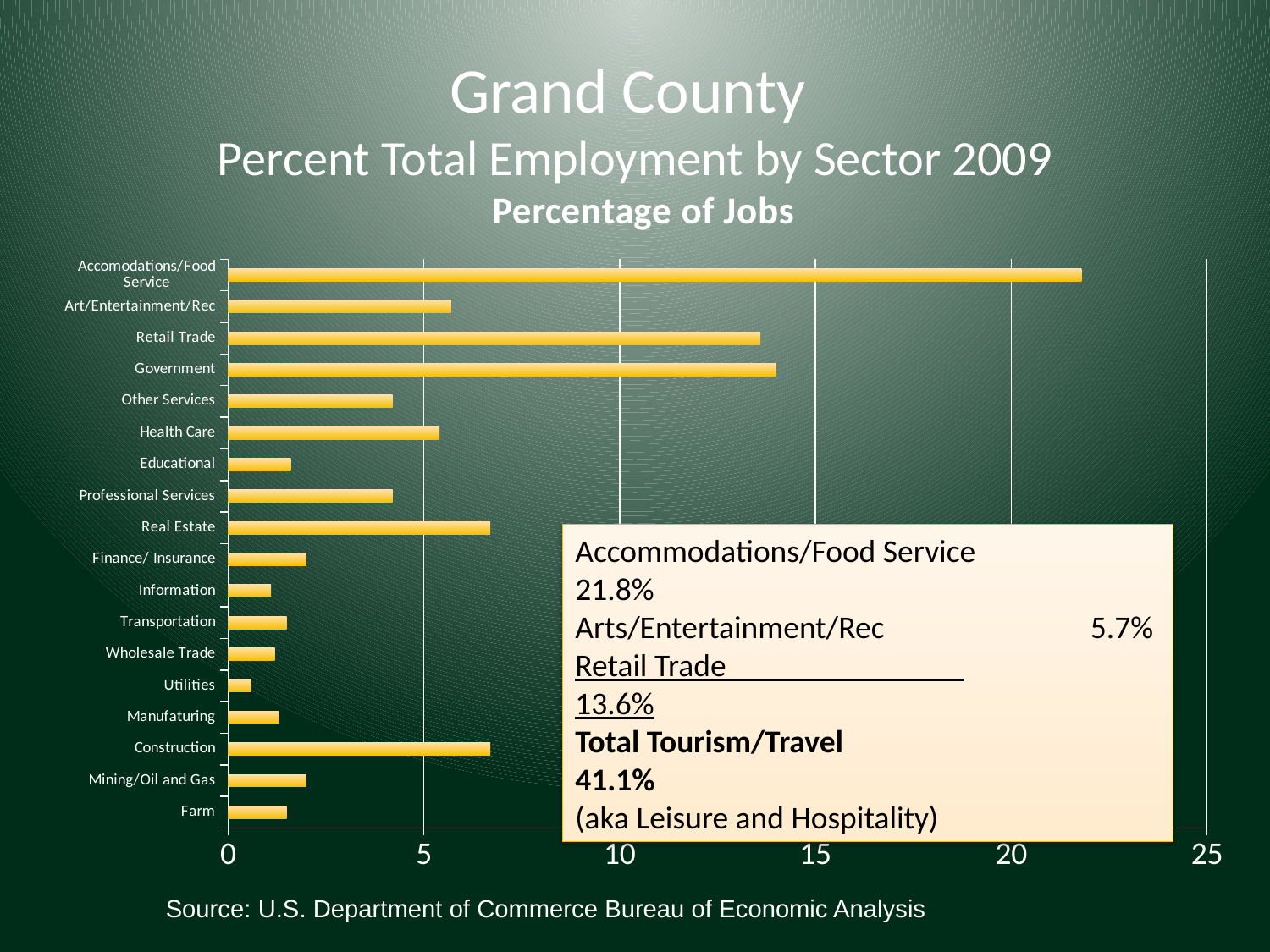
Which is larger, the value for Real Estate or the value for Health Care? Real Estate What is the difference between the Accommodations/Food Service and Retail Trade percentages? 8.2% Which sector has the lowest percentage of jobs? Utilities Which sector has the highest percentage of jobs? Accommodations/Food Service What is the percentage of jobs for Retail Trade? 13.6% How many sectors (categories) are plotted in the chart? 18 Is the value for Government greater or less than 10? greater What is the percentage of jobs for Arts/Entertainment/Rec? 5.7% What is the percentage of jobs for Accommodations/Food Service? 21.8% What is the chart's title shown above the plot area? Percentage of Jobs What type of chart is shown on the slide? Bar chart Is the value for Educational greater or less than 5? less